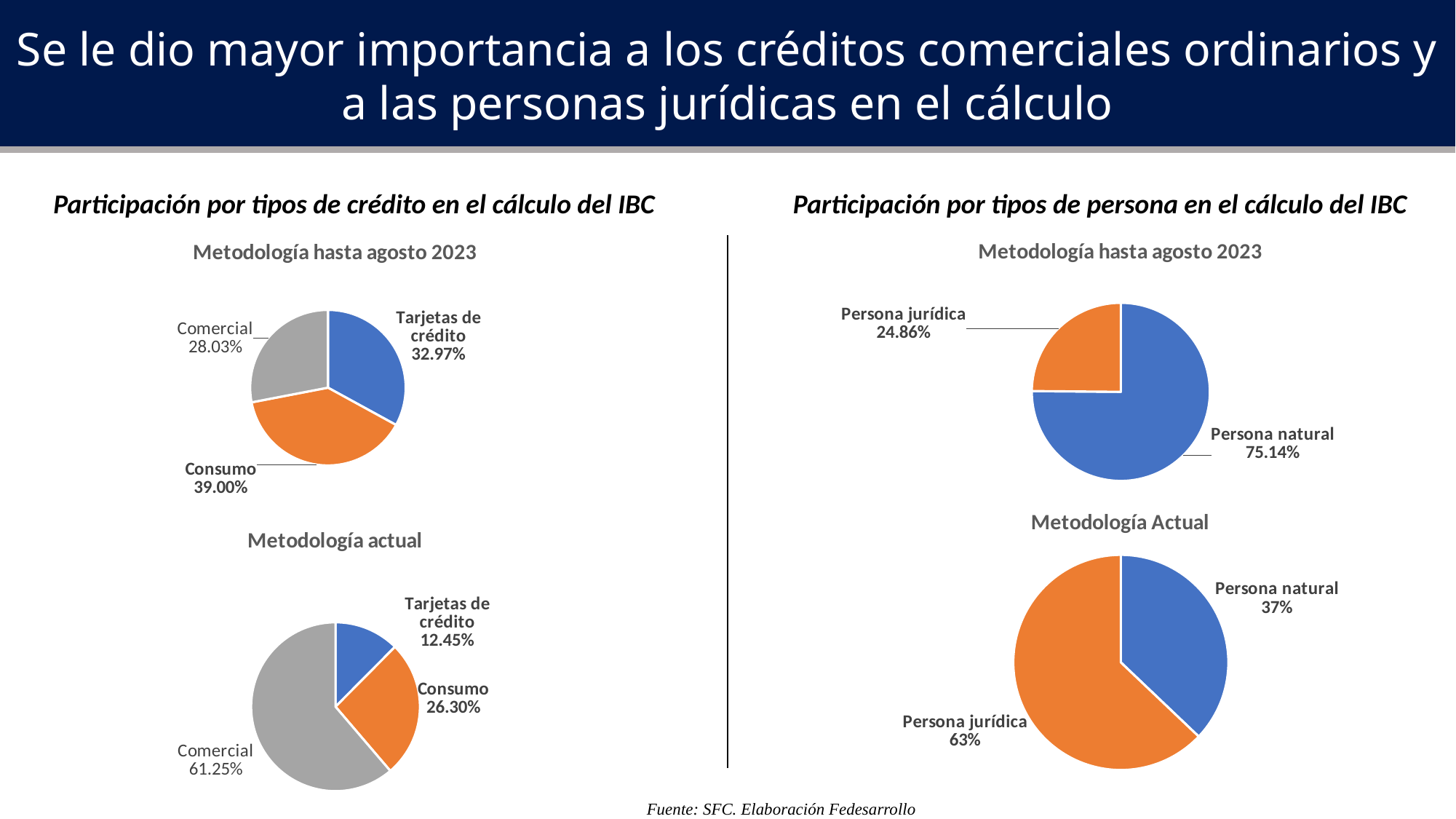
In the top-right pie chart (tipos de persona, Metodología hasta agosto 2023), what share does Persona jurídica have? 24.86% In the bottom-left pie chart (tipos de crédito, Metodología actual), what is the difference between the Comercial share and the Consumo share? 34.95% In the bottom-left pie chart (tipos de crédito, Metodología actual), which is larger: Tarjetas de crédito or Consumo? Consumo How many slices does the bottom-left pie chart (tipos de crédito, Metodología actual) have? 3 In the top-left pie chart (tipos de crédito, Metodología hasta agosto 2023), which category has the largest share? Consumo In the top-right pie chart (tipos de persona, Metodología hasta agosto 2023), what is the difference between Persona natural and Persona jurídica? 50.28% In the bottom-right pie chart (tipos de persona, Metodología Actual), what share does Persona jurídica have? 63% What type of chart is used for the bottom-right chart (tipos de persona, Metodología Actual)? Pie chart In the bottom-left pie chart (tipos de crédito, Metodología actual), what share does Comercial have? 61.25% In the top-left pie chart (tipos de crédito, Metodología hasta agosto 2023), what share does Consumo have? 39.00% What is the title of the chart group on the right side of the slide? Participación por tipos de persona en el cálculo del IBC In the top-left pie chart (tipos de crédito, Metodología hasta agosto 2023), which category has the smallest share? Comercial